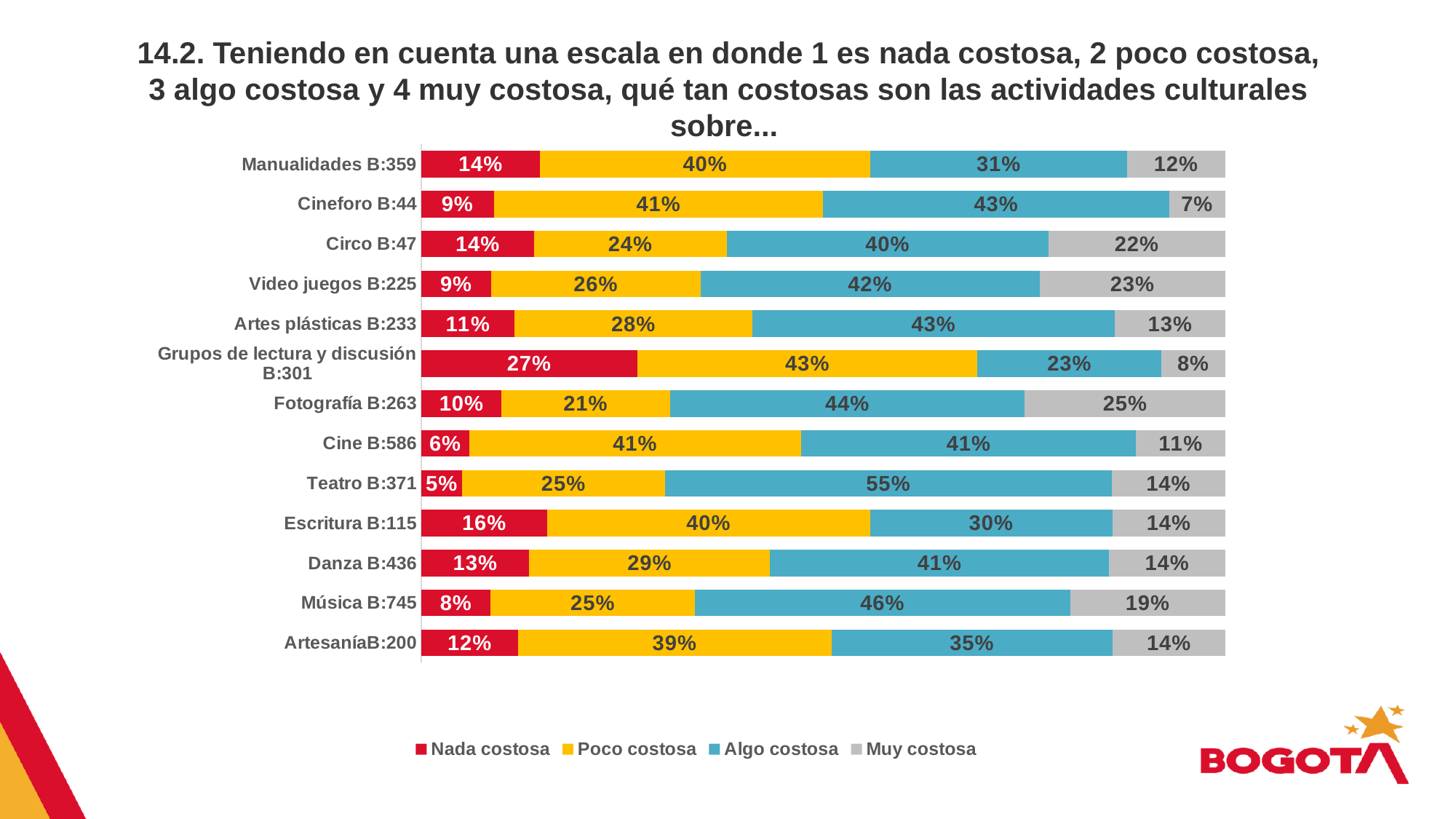
Which activity has the highest "Nada costosa" percentage? Grupos de lectura y discusión What is the "Nada costosa" value for Grupos de lectura y discusión? 27% What is the difference in percentage points between the "Muy costosa" values for Fotografía and Manualidades? 13 Which activity has the lowest "Nada costosa" percentage? Teatro What is the "Muy costosa" value for Fotografía? 25% How many activities are shown on the chart? 13 Which activity has the lowest "Muy costosa" percentage? Cineforo What type of chart is shown on the slide? Stacked bar chart How many series does the legend list? 4 Which is larger: the "Poco costosa" value for Cine or the "Poco costosa" value for Circo? Cine Which activity has the highest "Algo costosa" percentage? Teatro What percentage of respondents rated Teatro as "Algo costosa"? 55%